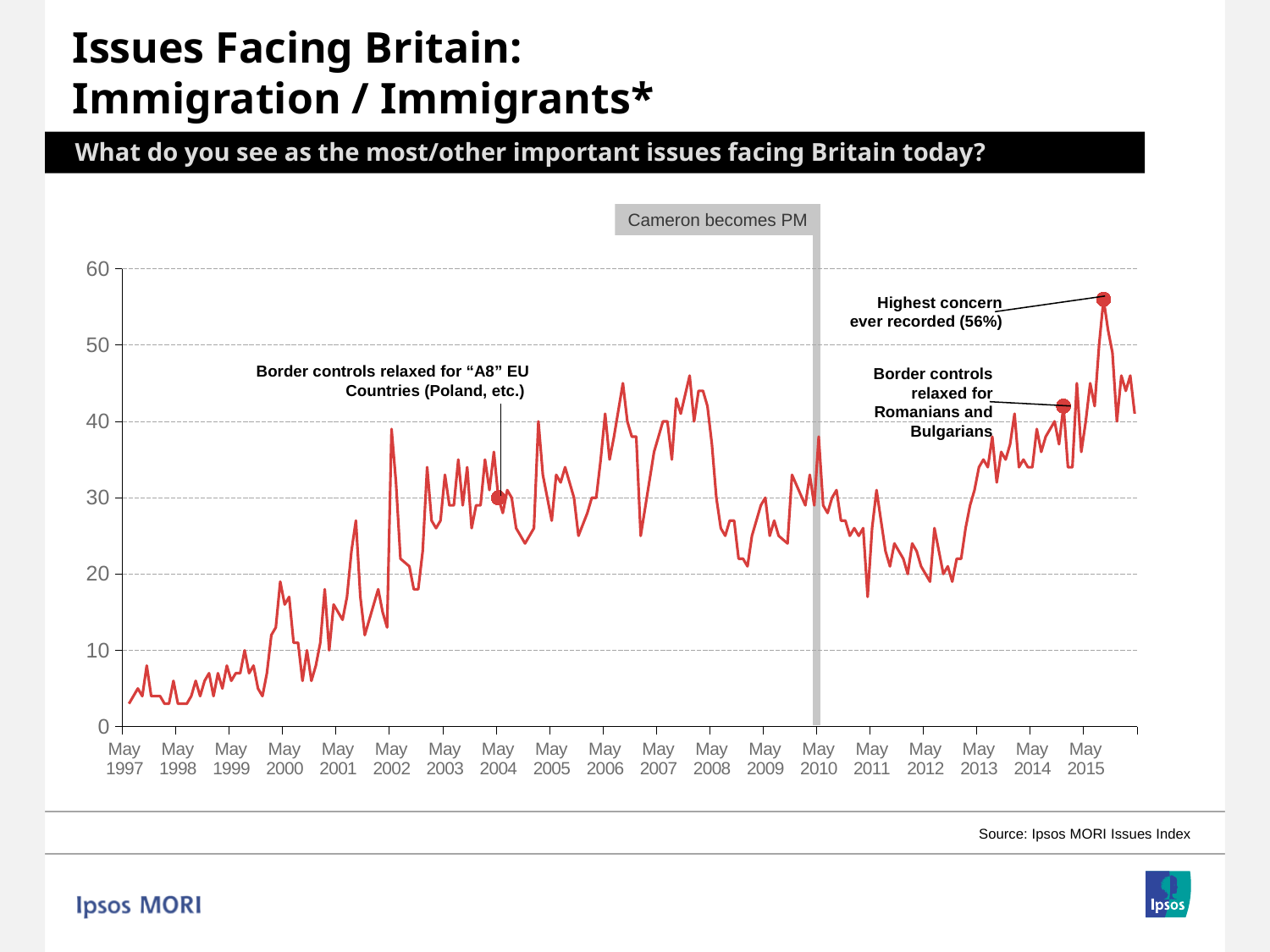
How many years are labelled on the x axis? 19 What kind of chart is shown on the slide? line chart In which year does the chart's highest value (56%) occur? 2015 Is the value at the point marked "Border controls relaxed for Romanians and Bulgarians" greater or less than 30? greater Is the peak value in 2015 greater or less than 50? greater What is the source given for the chart? Ipsos MORI Issues Index What is the highest level of concern ever recorded, as labelled on the chart? 56% Which is higher: the peak around 2002 or the peak in 2015? the peak in 2015 Overall, does the level of concern rise or fall between May 1997 and 2015? rise What event does the grey vertical bar on the chart mark? Cameron becomes PM Is the value at the start of the series in May 1997 greater or less than 10? less